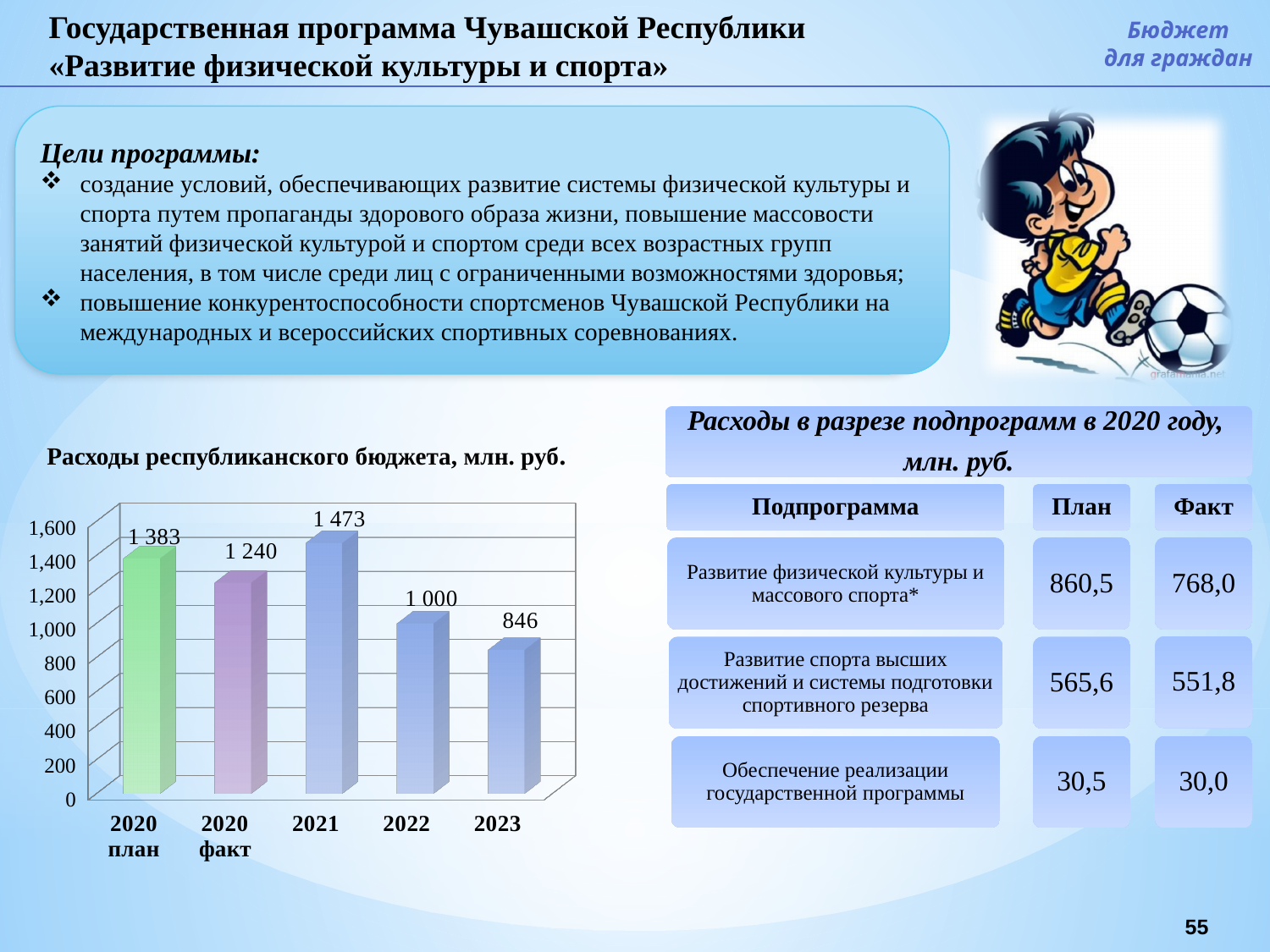
What is the value for 2021 in the chart 'Расходы республиканского бюджета, млн. руб.'? 1 473 What is the difference between the 2022 and 2023 values in the chart? 154 Is the value for 2023 in the chart greater or less than 1,000? less What is the value for 2020 план in the chart? 1 383 What is the value for 2023 in the chart? 846 What is the difference between the 2020 план and 2020 факт values in the chart? 143 Which is larger in the chart, the value for 2021 or the value for 2022? 2021 What kind of chart is shown on the slide? bar chart How many bars are shown in the chart? 5 Which category has the lowest value in the chart? 2023 What is the value for 2020 факт in the chart? 1 240 Which category has the highest value in the chart? 2021